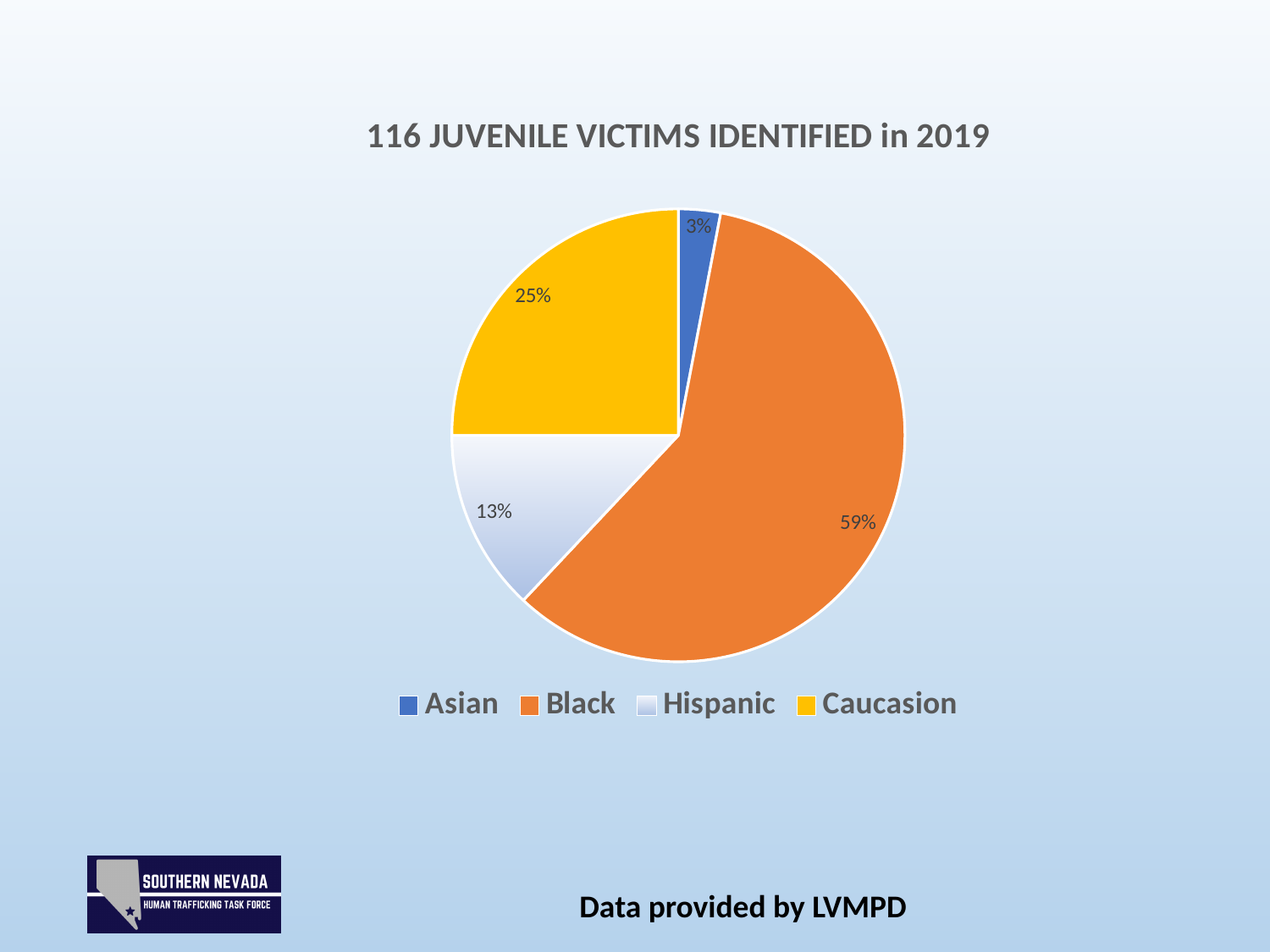
Which category has the smallest share of the pie? Asian What colour is the Caucasion slice? yellow Which category has the largest share of the pie? Black What type of chart is shown on the slide? pie chart What percentage of the pie is the Hispanic slice? 13% What is the difference in percentage points between the Black and Caucasion slices? 34 What percentage of the pie is the Asian slice? 3% What is the title of the chart? 116 JUVENILE VICTIMS IDENTIFIED in 2019 What percentage of the pie is the Caucasion slice? 25% Which slice is larger, Hispanic or Caucasion? Caucasion What percentage of the pie is the Black slice? 59% How many categories does the legend list? 4